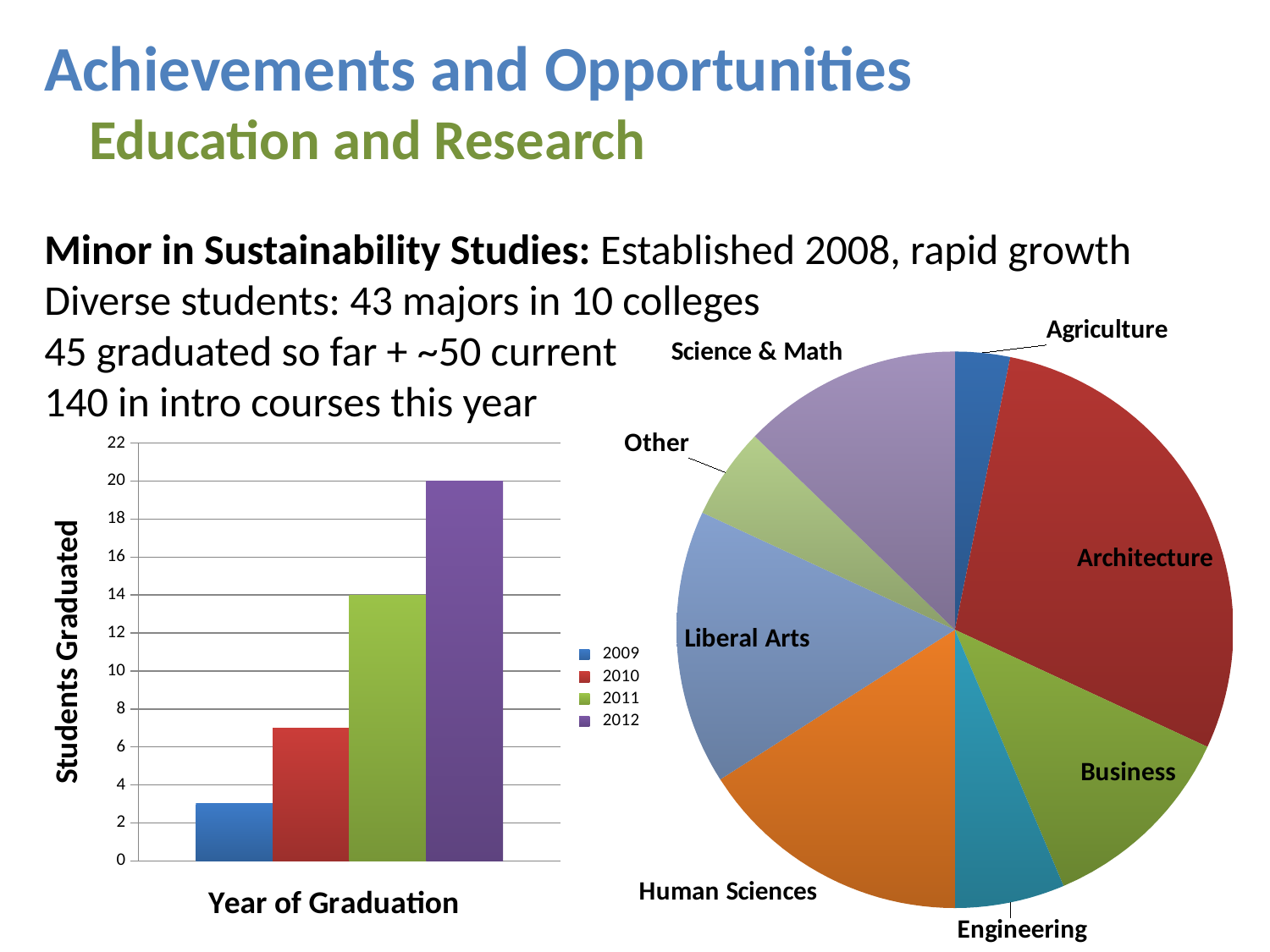
On the bar chart on the left, which year has the highest number of students graduated? 2012 On the bar chart on the left, is the value for 2009 greater or less than 4? less On the pie chart on the right, which college has the smallest slice? Agriculture On the bar chart on the left, what is the difference between the number of students graduated in 2012 and in 2011? 6 On the pie chart on the right, which college has the largest slice? Architecture On the pie chart on the right, how many slices are there? 8 On the bar chart on the left, how many students graduated in 2012? 20 On the bar chart on the left, which year has the lowest number of students graduated? 2009 On the bar chart on the left, is the value for 2010 greater or less than 6? greater On the bar chart on the left, how many entries does the legend list? 4 On the bar chart on the left, do the values rise or fall from 2009 to 2012? rise On the bar chart on the left, how many students graduated in 2011? 14